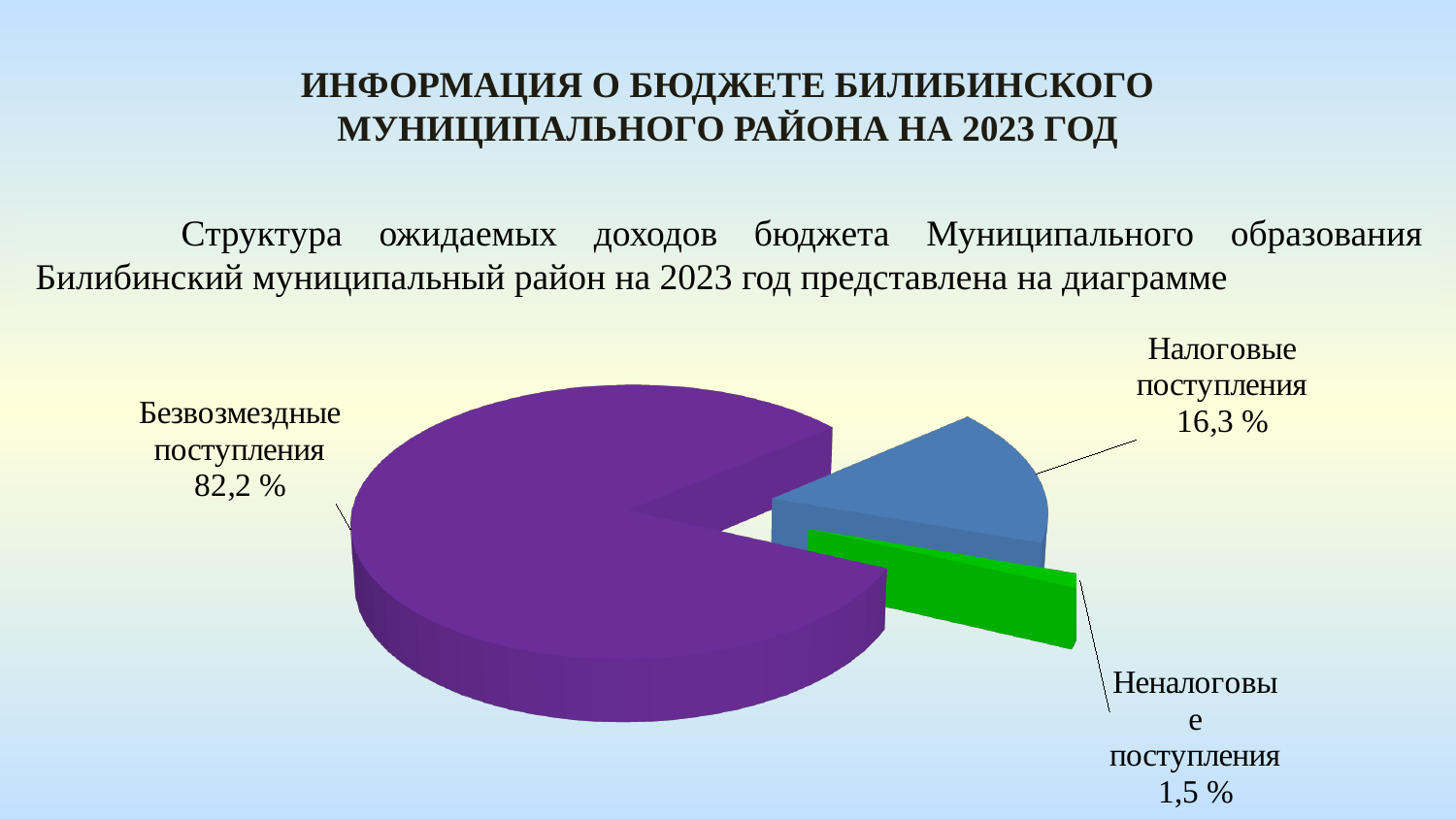
Which category has the largest slice of the pie? Безвозмездные поступления What share of the pie does Безвозмездные поступления represent? 82,2 % Which category has the smallest slice of the pie? Неналоговые поступления Which is larger: the share of Налоговые поступления or the share of Неналоговые поступления? Налоговые поступления What is the difference between the shares of Безвозмездные поступления and Налоговые поступления? 65,9 % What is the value shown for Налоговые поступления? 16,3 % What kind of chart is shown on the slide? Pie chart What is the difference between the shares of Налоговые поступления and Неналоговые поступления? 14,8 % What is the value shown for Неналоговые поступления? 1,5 % What colour is the slice for Неналоговые поступления? Green How many categories are shown in the pie chart? 3 What colour is the slice for Безвозмездные поступления? Purple